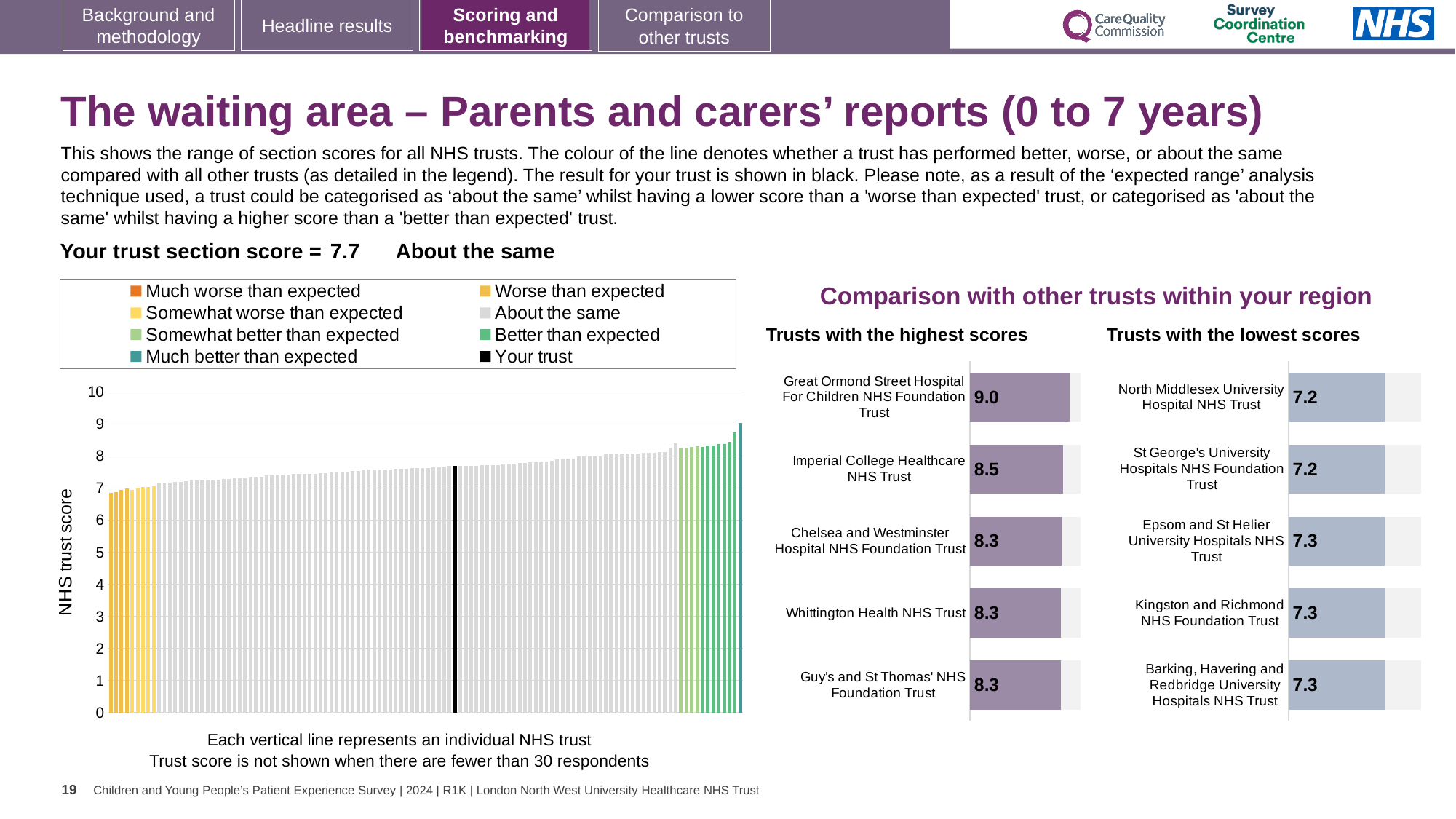
In the 'Trusts with the lowest scores' chart, what is the score for North Middlesex University Hospital NHS Trust? 7.2 In the 'Trusts with the highest scores' chart, what is the score for Imperial College Healthcare NHS Trust? 8.5 In the large chart on the left, do the trust scores rise or fall from left to right along the x axis? Rise In the 'Trusts with the lowest scores' chart, what is the score for Barking, Havering and Redbridge University Hospitals NHS Trust? 7.3 What kind of chart is the large chart on the left showing NHS trust scores? Bar chart In the 'Trusts with the highest scores' chart, what is the score for Great Ormond Street Hospital For Children NHS Foundation Trust? 9.0 Which has the higher score: Imperial College Healthcare NHS Trust in the 'highest scores' chart or Epsom and St Helier University Hospitals NHS Trust in the 'lowest scores' chart? Imperial College Healthcare NHS Trust In the large chart on the left, is the value of the black bar (your trust) greater or less than 7? greater How many entries does the legend of the large chart on the left list? 8 In the 'Trusts with the highest scores' chart, which trust has the highest score? Great Ormond Street Hospital For Children NHS Foundation Trust How many trusts are listed in the 'Trusts with the lowest scores' chart? 5 In the 'Trusts with the highest scores' chart, what is the difference between the scores of Great Ormond Street Hospital For Children NHS Foundation Trust and Imperial College Healthcare NHS Trust? 0.5